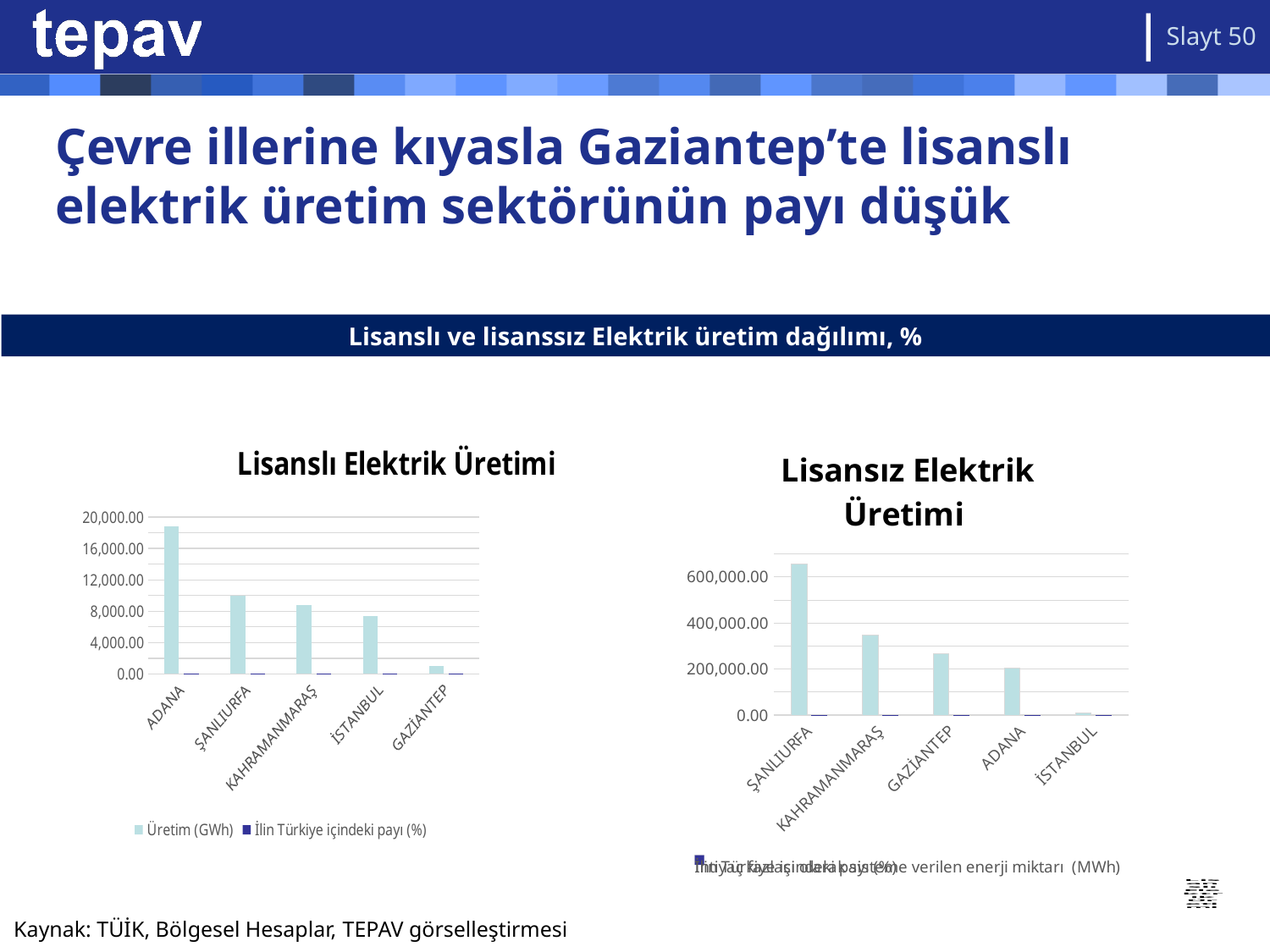
In the 'Lisansız Elektrik Üretimi' chart, is the value for KAHRAMANMARAŞ greater or less than 400,000.00? less In the 'Lisanslı Elektrik Üretimi' chart, is the Üretim (GWh) value for GAZİANTEP greater or less than 4,000.00? less In the 'Lisansız Elektrik Üretimi' chart, is the value for ŞANLIURFA greater or less than 600,000.00? greater In the 'Lisanslı Elektrik Üretimi' chart, how many series does the legend list? 2 What type of chart is the 'Lisanslı Elektrik Üretimi' chart? Bar chart In the 'Lisansız Elektrik Üretimi' chart, which province has the lowest bar? İSTANBUL In the 'Lisanslı Elektrik Üretimi' chart, how many provinces are shown on the x axis? 5 In the 'Lisansız Elektrik Üretimi' chart, which province has the highest bar? ŞANLIURFA In the 'Lisanslı Elektrik Üretimi' chart, which province has the lowest Üretim (GWh) bar? GAZİANTEP In the 'Lisanslı Elektrik Üretimi' chart, which province has the highest Üretim (GWh) bar? ADANA